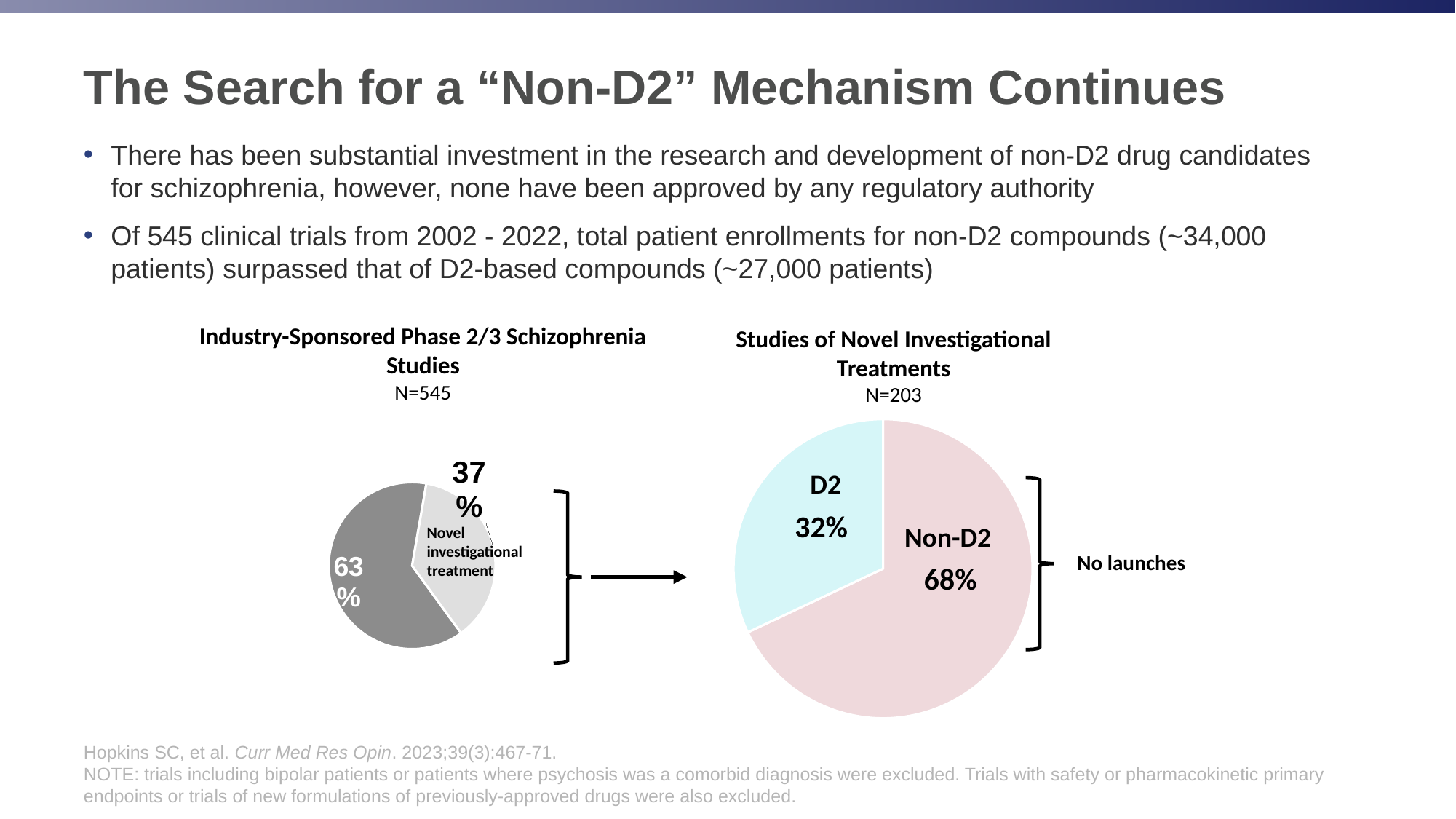
What is the N value shown under the 'Industry-Sponsored Phase 2/3 Schizophrenia Studies' chart title? N=545 In the 'Studies of Novel Investigational Treatments' pie chart, which slice is larger, D2 or Non-D2? Non-D2 In the 'Studies of Novel Investigational Treatments' pie chart, what share of studies is D2? 32% How many slices does the 'Studies of Novel Investigational Treatments' pie chart have? 2 In the 'Industry-Sponsored Phase 2/3 Schizophrenia Studies' pie chart, what is the difference in percentage points between the 63% slice and the 37% slice? 26 percentage points In the 'Studies of Novel Investigational Treatments' pie chart, which slice is the smallest? D2 In the 'Studies of Novel Investigational Treatments' pie chart, what is the difference in percentage points between the Non-D2 and D2 slices? 36 percentage points In the 'Studies of Novel Investigational Treatments' pie chart, what share of studies is Non-D2? 68% In the 'Industry-Sponsored Phase 2/3 Schizophrenia Studies' pie chart, what share is labelled 'Novel investigational treatment'? 37% What type of chart is used for 'Studies of Novel Investigational Treatments'? Pie chart In the 'Industry-Sponsored Phase 2/3 Schizophrenia Studies' pie chart, what percentage is shown on the dark grey slice? 63% What is the N value shown under the 'Studies of Novel Investigational Treatments' chart title? N=203